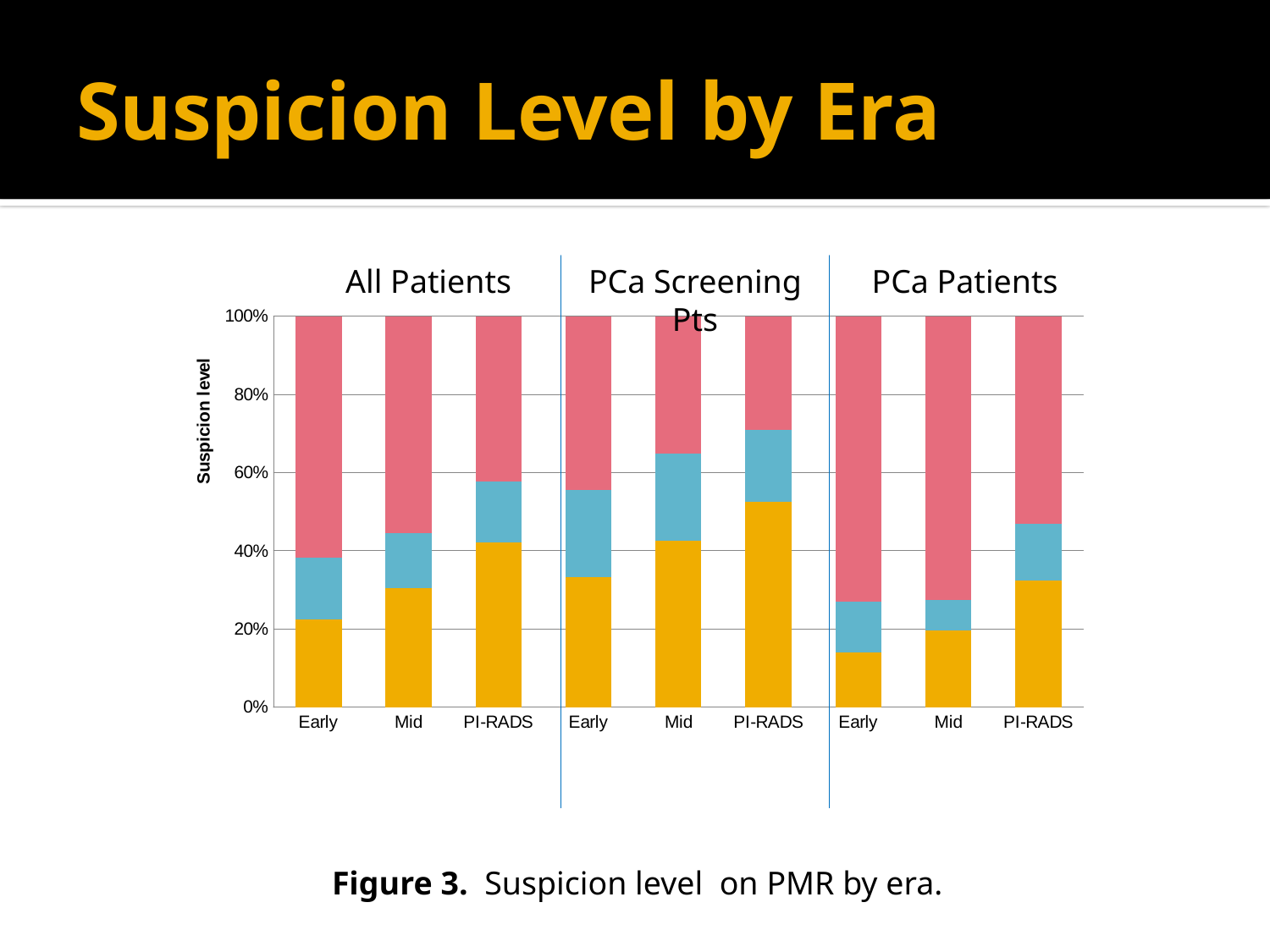
Is the yellow (bottom) segment of the Early bar in the PCa Patients group greater or less than 20%? less Which bar has the largest yellow (bottom) segment? PI-RADS in PCa Screening Pts Within the All Patients group, does the yellow (bottom) segment rise or fall from Early to PI-RADS? rise How many bars are plotted in the chart? 9 Is the yellow (bottom) segment of the PI-RADS bar in the PCa Screening Pts group greater or less than 40%? greater What kind of chart is shown on the slide? Stacked bar chart How many patient groups are shown across the top of the chart? 3 What are the three patient groups labelled above the chart? All Patients, PCa Screening Pts, PCa Patients Is the yellow (bottom) segment of the Early bar in the All Patients group greater or less than 40%? less What is the label of the vertical axis? Suspicion level What is the total height of each stacked bar on the percentage axis? 100% Which has the larger yellow (bottom) segment: the PI-RADS bar in PCa Screening Pts or the PI-RADS bar in PCa Patients? PI-RADS in PCa Screening Pts